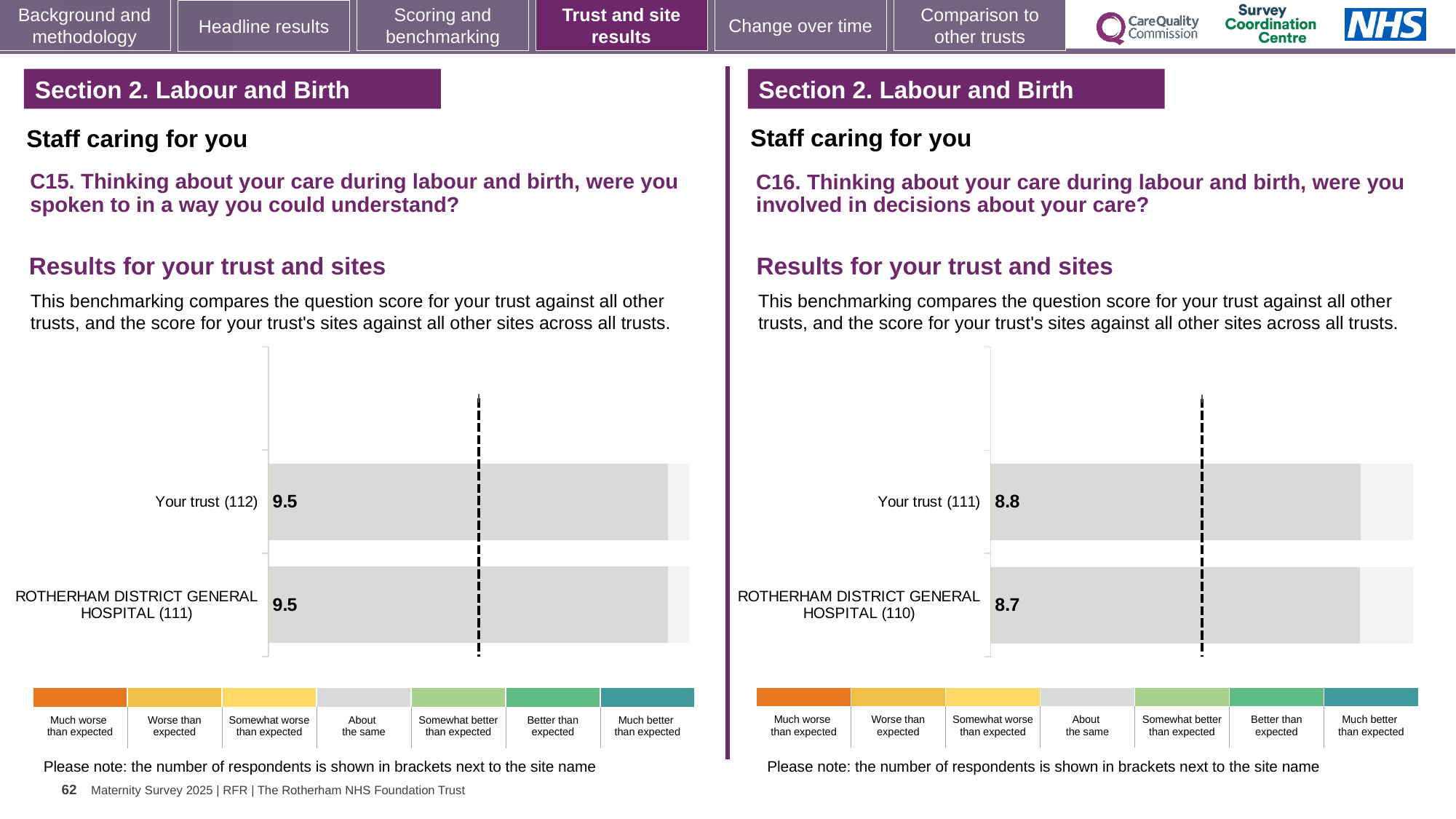
In the right chart (C16), what is the score for ROTHERHAM DISTRICT GENERAL HOSPITAL (110)? 8.7 In the left chart (C15), how many respondents are shown in brackets for ROTHERHAM DISTRICT GENERAL HOSPITAL? 111 What type of chart is used in the left chart (C15)? Bar chart In the right chart (C16), what is the difference between the score for Your trust (111) and the score for ROTHERHAM DISTRICT GENERAL HOSPITAL (110)? 0.1 In the left chart (C15), what is the score for ROTHERHAM DISTRICT GENERAL HOSPITAL (111)? 9.5 What is the difference between the Your trust score in the left chart (C15) and the Your trust score in the right chart (C16)? 0.7 How many bars are plotted in the left chart (C15)? 2 In the left chart (C15), what is the difference between the score for Your trust (112) and the score for ROTHERHAM DISTRICT GENERAL HOSPITAL (111)? 0 In the right chart (C16), which has the higher score, Your trust (111) or ROTHERHAM DISTRICT GENERAL HOSPITAL (110)? Your trust (111) How many bars are plotted in the right chart (C16)? 2 In the right chart (C16), what is the score for Your trust (111)? 8.8 In the left chart (C15), what is the score for Your trust (112)? 9.5